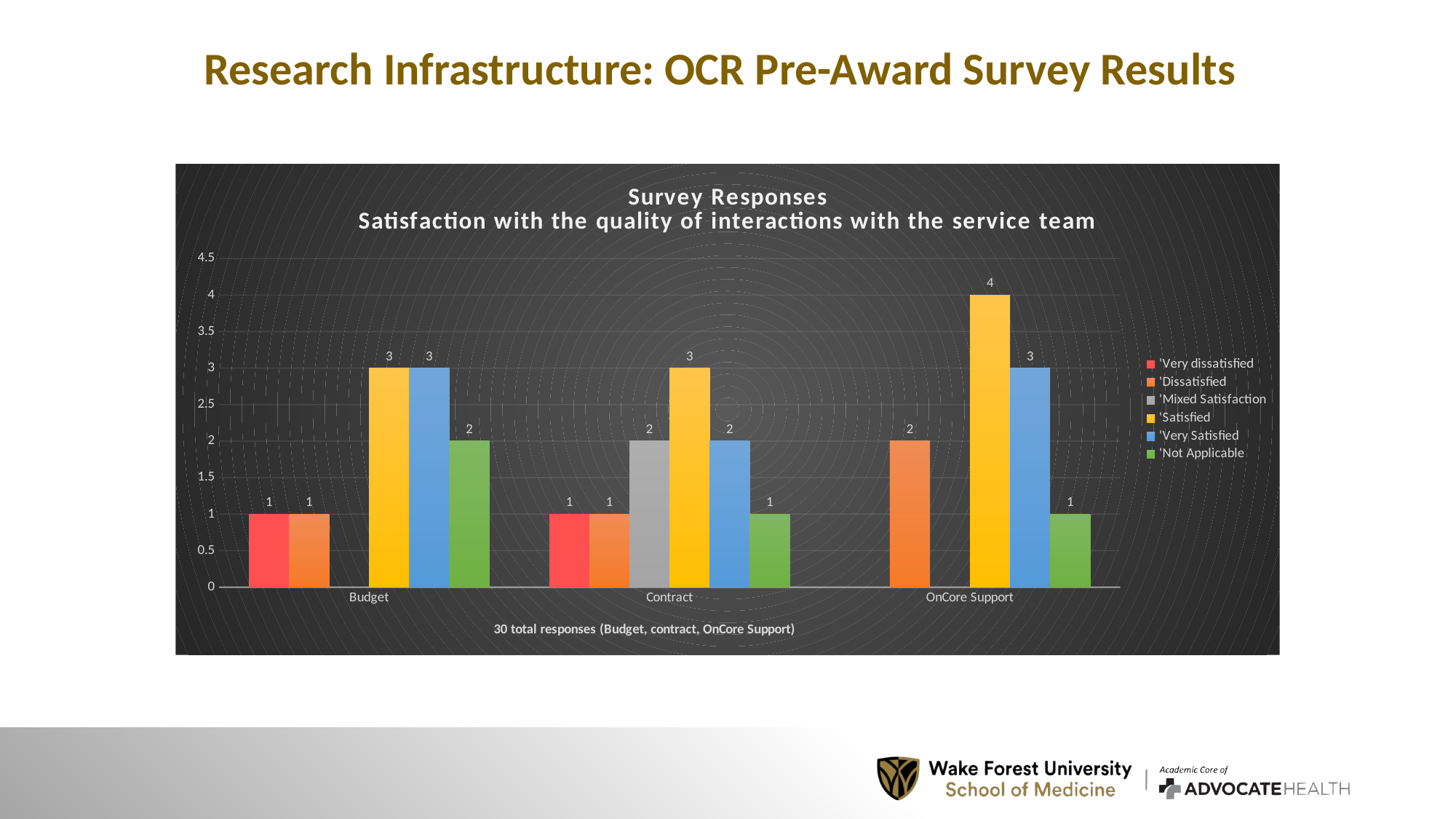
What is the value for Mixed Satisfaction in the Contract category? 2 What kind of chart is shown on the slide? Bar chart What is the value for Not Applicable in the Budget category? 2 What is the value for Satisfied in the OnCore Support category? 4 How many series does the legend list? 6 What is the title of the chart? Survey Responses Satisfaction with the quality of interactions with the service team How many categories are shown on the x axis? 3 Which category has the highest Satisfied value? OnCore Support Which is larger: the Very Satisfied value for Budget or the Very Satisfied value for Contract? Budget Which category has the lowest Very Satisfied value? Contract What is the value for Dissatisfied in the OnCore Support category? 2 What is the difference between the Satisfied value for OnCore Support and the Satisfied value for Budget? 1